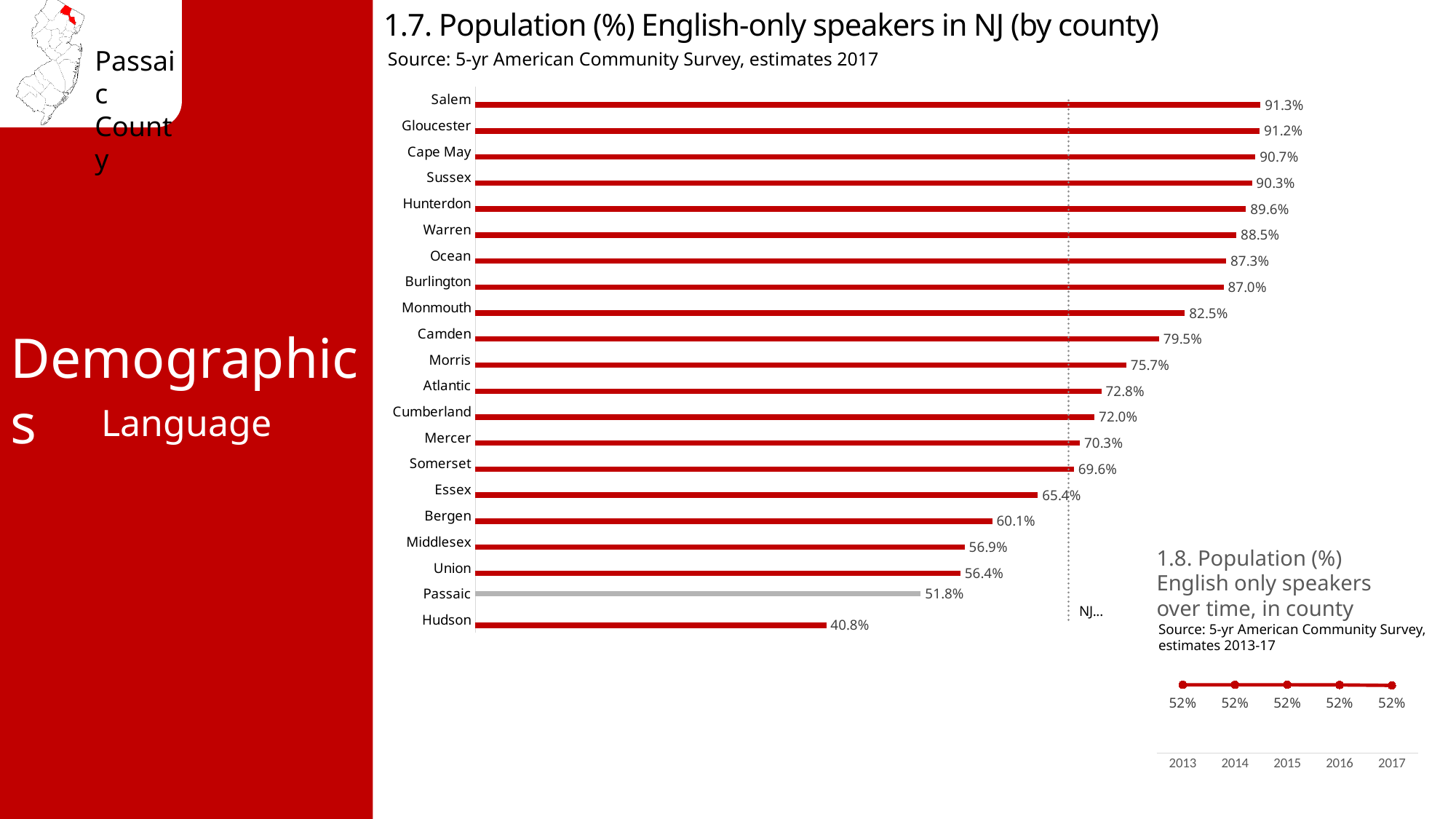
In the chart '1.7. Population (%) English-only speakers in NJ (by county)', what is the value for Morris? 75.7% In the chart '1.8. Population (%) English only speakers over time, in county', what is the value for 2015? 52% In the chart '1.7. Population (%) English-only speakers in NJ (by county)', which county's bar is shown in grey instead of red? Passaic In the chart '1.7. Population (%) English-only speakers in NJ (by county)', how many counties are shown? 21 In the chart '1.7. Population (%) English-only speakers in NJ (by county)', which county has the lowest value? Hudson What kind of chart is '1.7. Population (%) English-only speakers in NJ (by county)'? Bar chart In the chart '1.7. Population (%) English-only speakers in NJ (by county)', which has a larger value, Bergen or Essex? Essex In the chart '1.7. Population (%) English-only speakers in NJ (by county)', which county has the highest value? Salem In the chart '1.8. Population (%) English only speakers over time, in county', do the values rise, fall or stay flat from 2013 to 2017? Stay flat In the chart '1.8. Population (%) English only speakers over time, in county', how many years are plotted? 5 In the chart '1.7. Population (%) English-only speakers in NJ (by county)', what is the value for Passaic? 51.8% In the chart '1.7. Population (%) English-only speakers in NJ (by county)', what is the difference between the values for Salem and Hudson? 50.5%